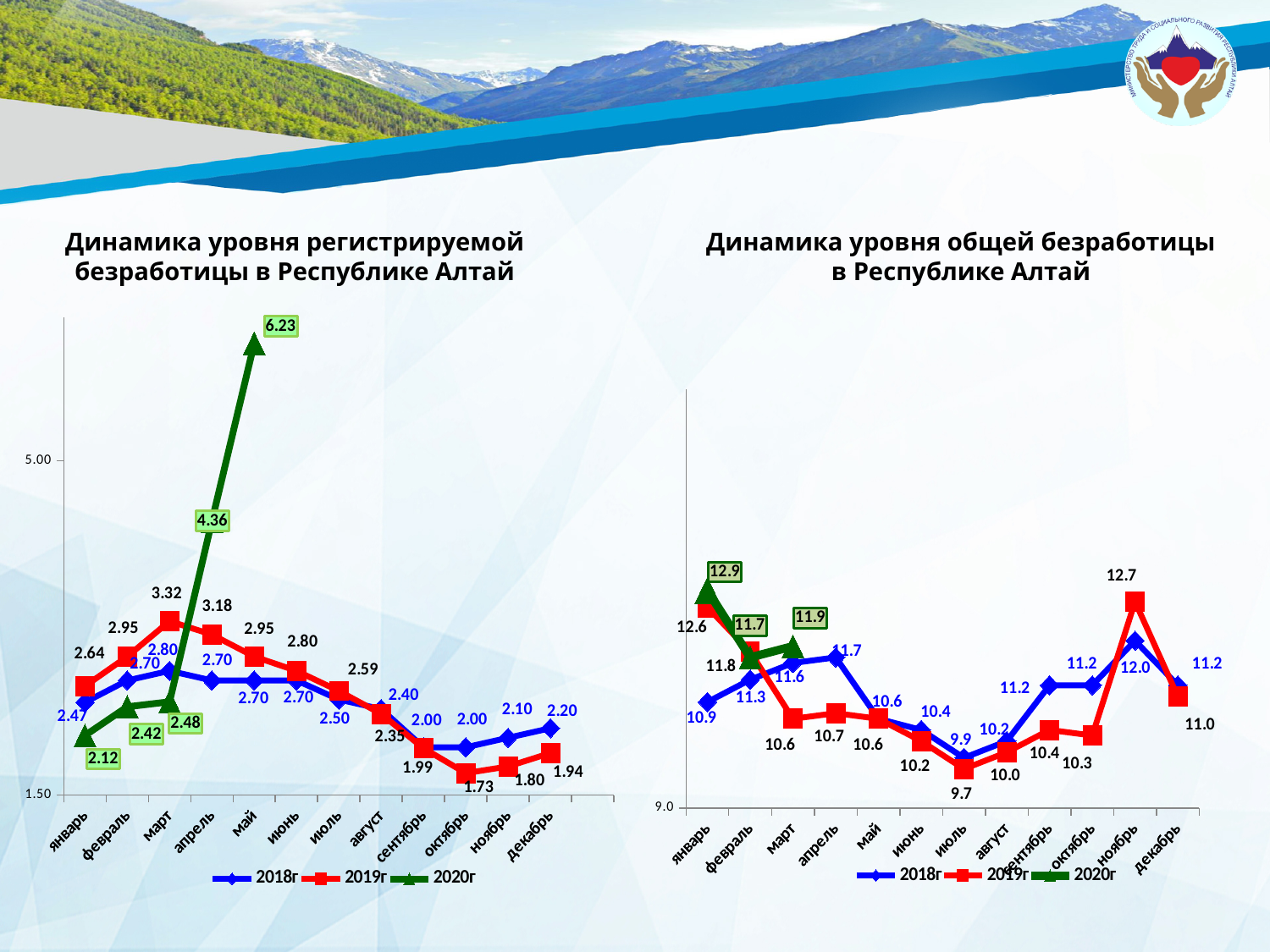
What type of chart is the right chart (Динамика уровня общей безработицы)? line chart On the right chart (Динамика уровня общей безработицы), what is the value for 2020г in январь? 12.9 On the right chart (Динамика уровня общей безработицы), what is the value for 2019г in ноябрь? 12.7 On the left chart (Динамика уровня регистрируемой безработицы), in which month does the 2019г series reach its lowest value? октябрь On the left chart (Динамика уровня регистрируемой безработицы), which is larger in январь: the 2018г value or the 2019г value? 2019г On the right chart (Динамика уровня общей безработицы), what is the difference between the 2018г and 2019г values in декабрь? 0.2 On the left chart (Динамика уровня регистрируемой безработицы), what is the value for 2019г in март? 3.32 On the right chart (Динамика уровня общей безработицы), how many months are shown on the x axis? 12 On the left chart (Динамика уровня регистрируемой безработицы), what is the value for 2020г in май? 6.23 On the left chart (Динамика уровня регистрируемой безработицы), how many series does the legend list? 3 On the right chart (Динамика уровня общей безработицы), in which month does the 2018г series reach its lowest value? июль On the left chart (Динамика уровня регистрируемой безработицы), what is the difference between the 2020г values for май and апрель? 1.87